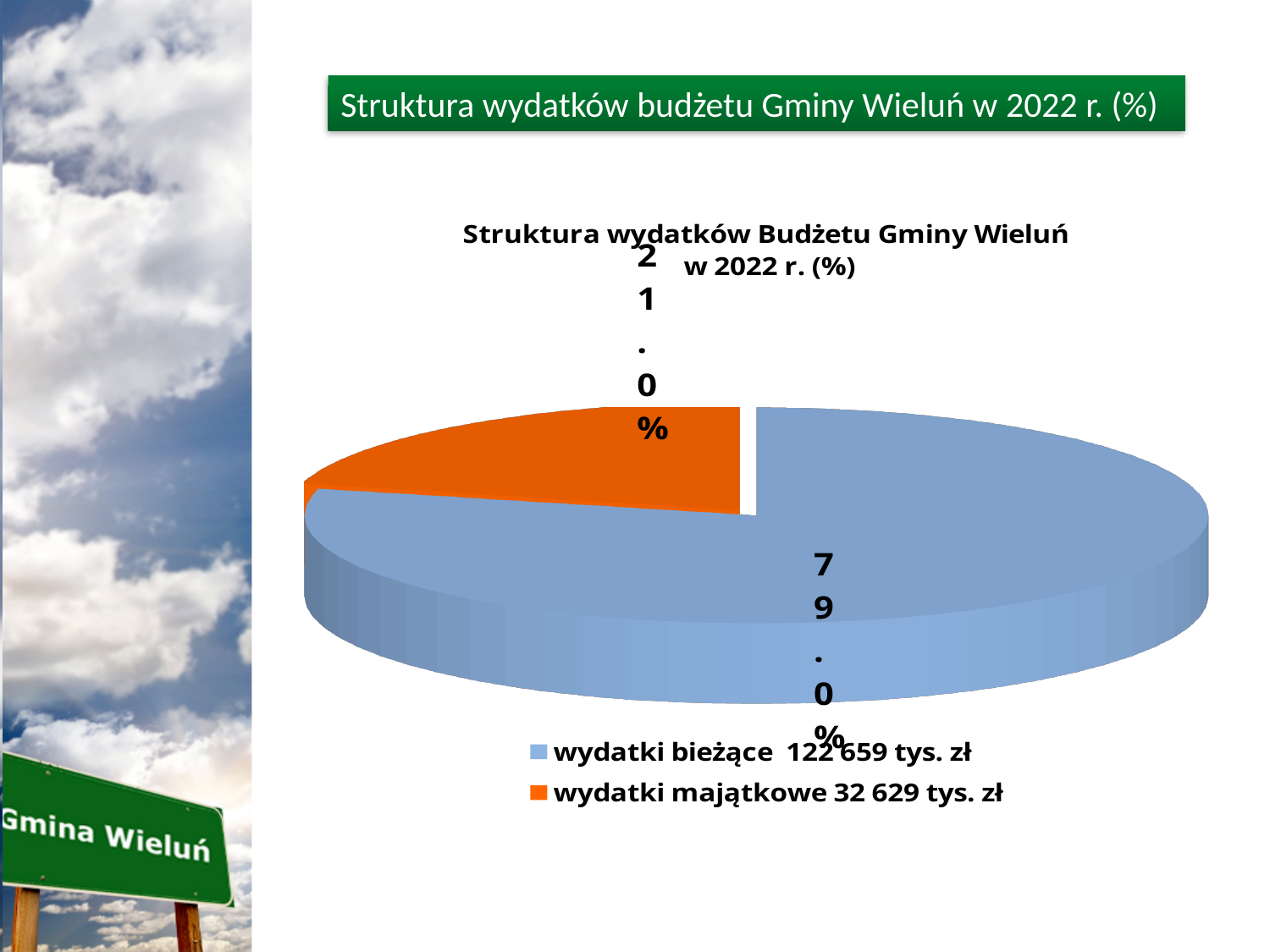
Which is larger, the share for wydatki bieżące or for wydatki majątkowe? wydatki bieżące How many entries does the legend list? 2 Which category has the smallest share of the pie? wydatki majątkowe What amount in tys. zł is given in the legend for wydatki majątkowe? 32 629 tys. zł What is the title of the chart? Struktura wydatków Budżetu Gminy Wieluń w 2022 r. (%) What kind of chart is shown on the slide? pie chart What percentage share is shown for wydatki bieżące? 79.0% What percentage share is shown for wydatki majątkowe? 21.0% What colour is the slice for wydatki bieżące? blue How many slices does the pie chart have? 2 Which category has the largest share of the pie? wydatki bieżące What is the difference in percentage points between the share of wydatki bieżące and wydatki majątkowe? 58.0